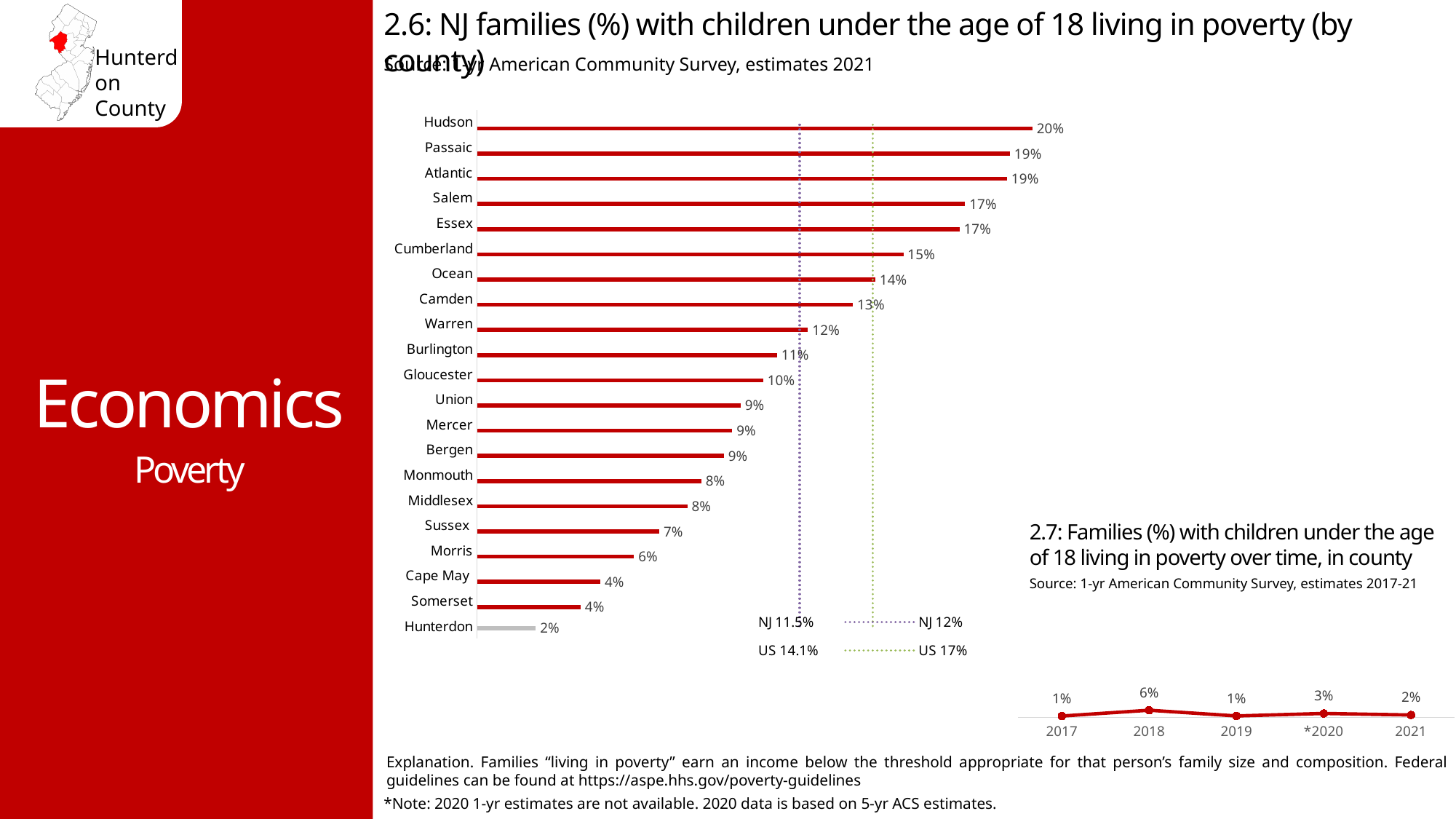
In chart 2.6, what is the value for Hunterdon? 2% What kind of chart is chart 2.6? Bar chart In chart 2.7, which year has the highest value? 2018 In chart 2.6, which county has the highest percentage of families with children living in poverty? Hudson In chart 2.6, which county has a larger value, Cumberland or Camden? Cumberland In chart 2.6 (NJ families with children under 18 living in poverty by county), what is the value for Hudson? 20% In chart 2.6, how many counties are plotted? 21 In chart 2.7, how many years are plotted? 5 In chart 2.7 (families with children living in poverty over time, in county), what is the value for 2018? 6% In chart 2.6, what is the difference between the values for Hudson and Hunterdon? 18% In chart 2.6, which county has the lowest percentage? Hunterdon